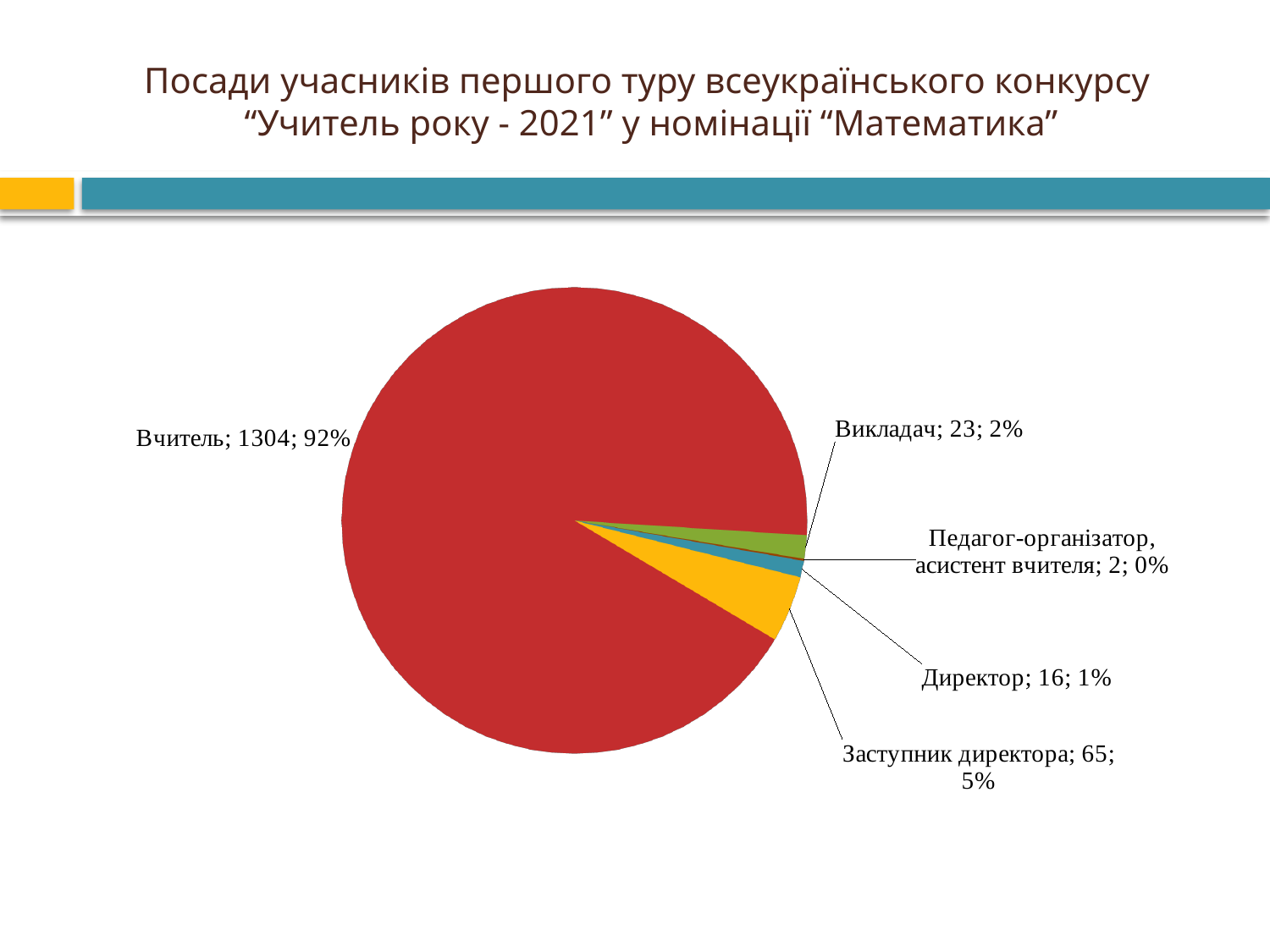
What is the value for Директор? 16 What is the value for Вчитель? 1304 What share of the pie does Заступник директора represent? 5% Which category has the largest slice? Вчитель How many slices does the pie chart have? 5 What is the value for Педагог-організатор, асистент вчителя? 2 What is the difference between the values for Заступник директора and Викладач? 42 What is the value for Викладач? 23 What kind of chart is shown on the slide? Pie chart Which category has the smallest slice? Педагог-організатор, асистент вчителя Which is larger, the value for Директор or the value for Викладач? Викладач What is the value for Заступник директора? 65